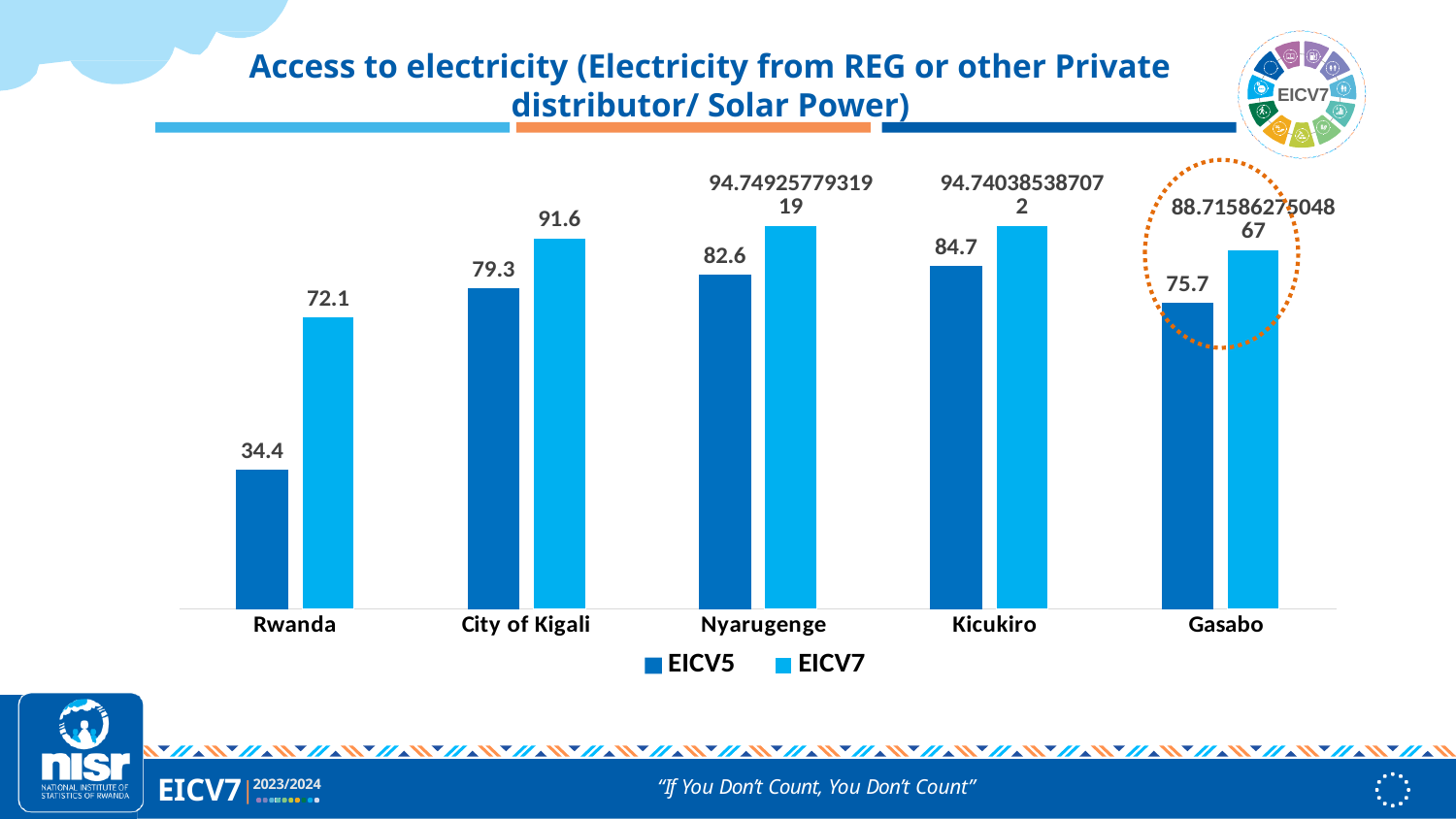
What is the EICV5 value for Rwanda? 34.4 What kind of chart is shown on the slide? Bar chart What is the EICV7 value for City of Kigali? 91.6 Which category has the lowest EICV7 value? Rwanda Which category has the highest EICV5 value? Kicukiro What is the EICV5 value for Gasabo? 75.7 What is the difference between the EICV7 and EICV5 values for City of Kigali? 12.3 Which is larger, the EICV5 value for Kicukiro or the EICV5 value for Nyarugenge? Kicukiro How many categories are shown on the x axis? 5 How many series does the legend list? 2 What is the EICV7 value for Rwanda? 72.1 What is the difference between the EICV7 and EICV5 values for Rwanda? 37.7